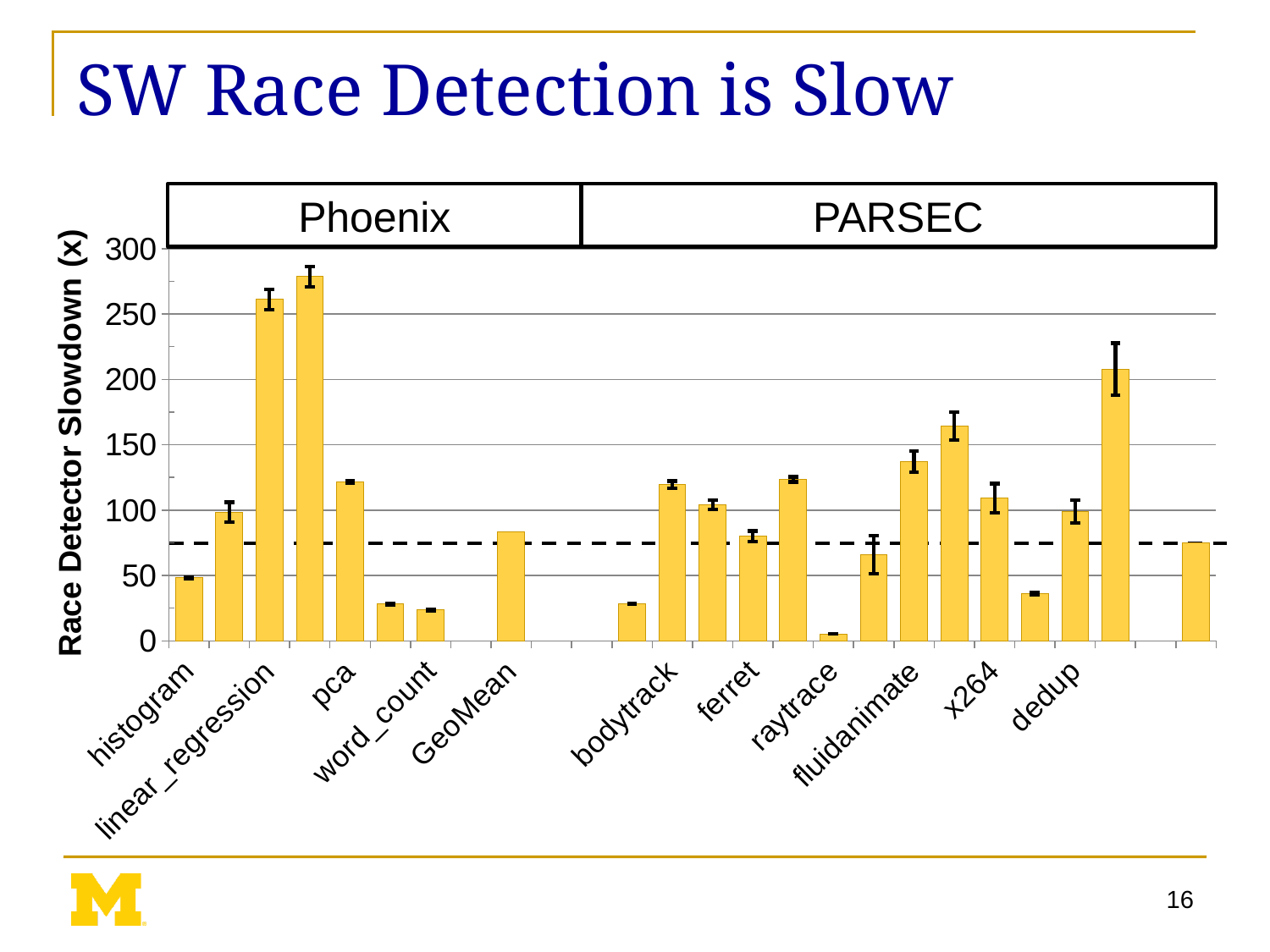
Is the value for GeoMean in the Phoenix group greater or less than 100? less Is the value for pca greater or less than 100? greater Which has the larger slowdown, histogram or pca? pca Is the value for fluidanimate greater or less than 150? less What is the label of the vertical axis? Race Detector Slowdown (x) What type of chart is shown on the slide? bar chart Which has the larger slowdown, word_count or pca? pca Which group, Phoenix or PARSEC, contains the tallest bar in the chart? Phoenix What are the two benchmark suite groups labelled above the chart? Phoenix and PARSEC